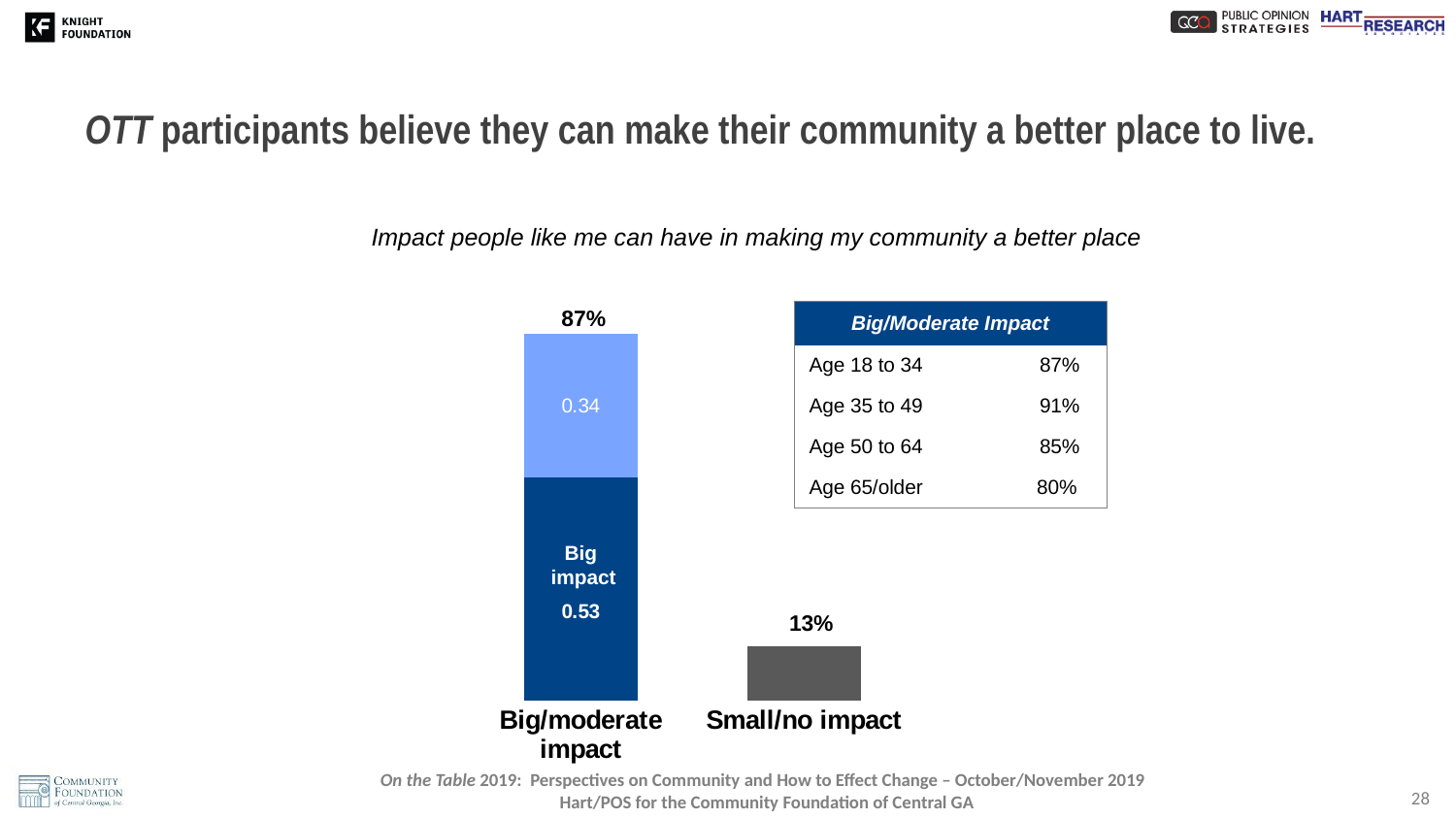
In the Big/Moderate Impact table, what is the percentage for Age 65/older? 80% Which category has the lowest value in the chart? Small/no impact What is the value shown for Small/no impact? 13% What kind of chart is shown on the slide? bar chart What value is printed on the Big impact segment of the Big/moderate impact bar? 0.53 What is the total value shown above the Big/moderate impact bar? 87% Which category has the higher value, Big/moderate impact or Small/no impact? Big/moderate impact What is the subtitle printed above the chart? Impact people like me can have in making my community a better place What is the difference between the Big/moderate impact total and the Small/no impact value? 74% What value is printed on the upper (light blue) segment of the Big/moderate impact bar? 0.34 How many categories are shown on the x axis of the chart? 2 In the Big/Moderate Impact table, which age group has the highest percentage? Age 35 to 49